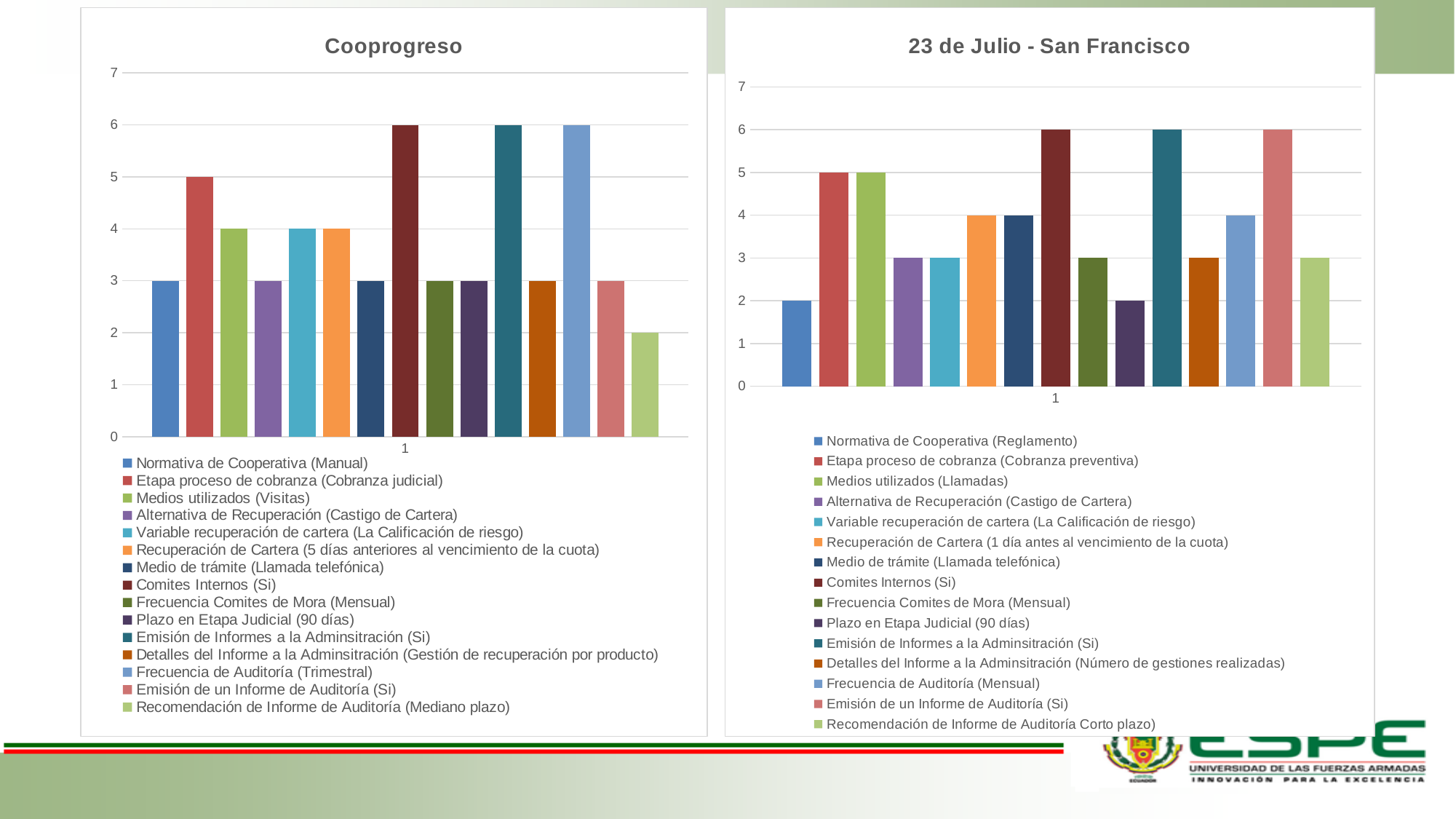
What type of chart is the "Cooprogreso" chart? bar chart In the "Cooprogreso" chart, what is the value for Recomendación de Informe de Auditoría (Mediano plazo)? 2 In the "23 de Julio - San Francisco" chart, what is the value for Normativa de Cooperativa (Reglamento)? 2 What is the title of the chart on the right side of the slide? 23 de Julio - San Francisco In the "23 de Julio - San Francisco" chart, what is the value for Emisión de un Informe de Auditoría (Si)? 6 In the "Cooprogreso" chart, what is the value for Etapa proceso de cobranza (Cobranza judicial)? 5 In the "23 de Julio - San Francisco" chart, which is larger: Medios utilizados (Llamadas) or Frecuencia de Auditoría (Mensual)? Medios utilizados (Llamadas) In the "Cooprogreso" chart, which series has the lowest value? Recomendación de Informe de Auditoría (Mediano plazo) In the "23 de Julio - San Francisco" chart, is the value for Comites Internos (Si) greater or less than 5? greater How many series does the legend of the "Cooprogreso" chart list? 15 In the "Cooprogreso" chart, what is the difference between Comites Internos (Si) and Normativa de Cooperativa (Manual)? 3 In the "23 de Julio - San Francisco" chart, what is the difference between Etapa proceso de cobranza (Cobranza preventiva) and Plazo en Etapa Judicial (90 días)? 3